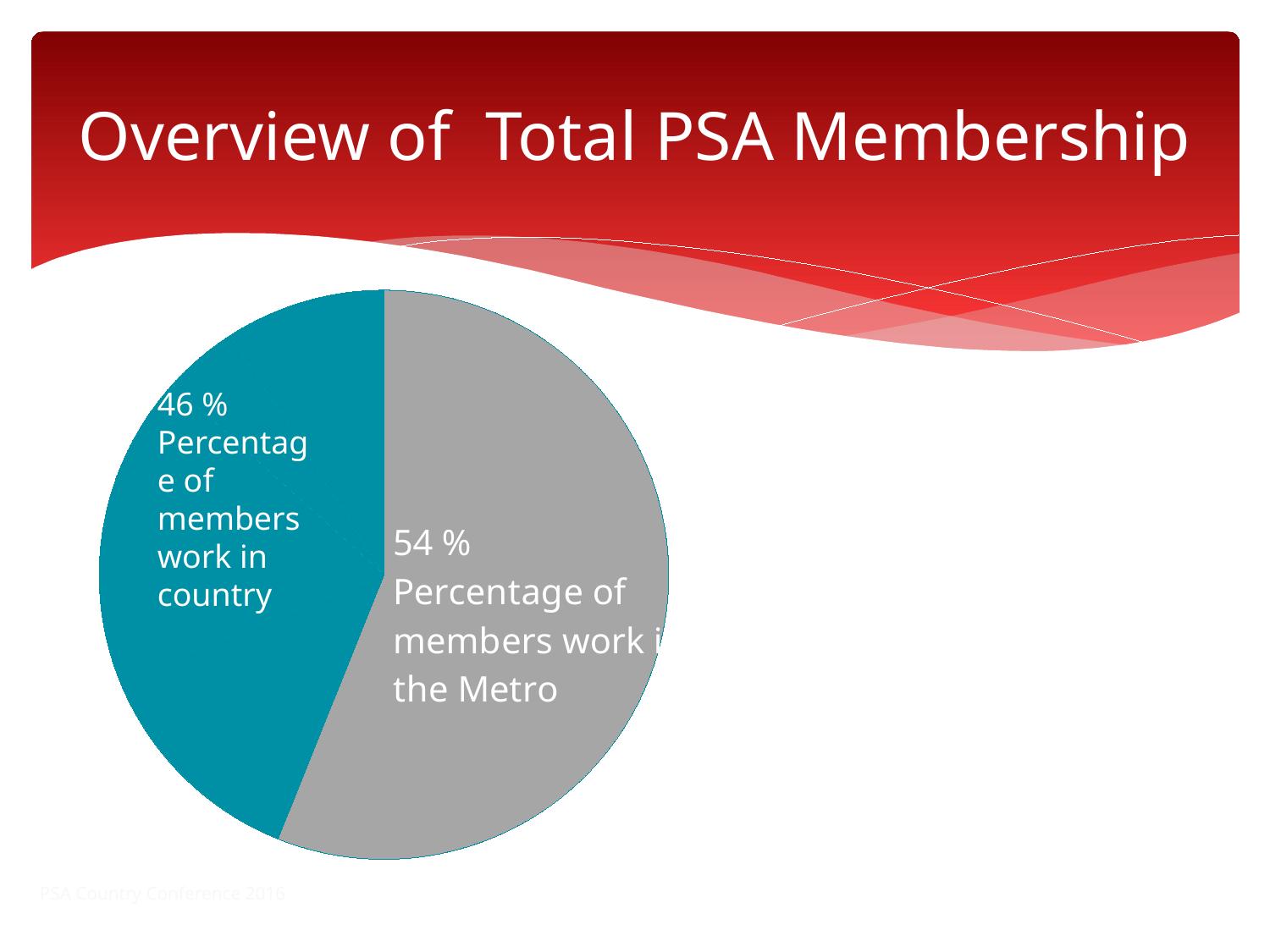
Which group has the smallest share of the pie? members work in country Is the share of members working in country greater or less than 50%? less What is the difference in percentage points between the Metro share and the country share? 8 What kind of chart is shown on the slide? pie chart What percentage of members work in the Metro? 54 % Which slice of the pie is larger: members working in country or members working in the Metro? members work in the Metro What colour is the slice for members working in country? teal Which group has the largest share of the pie? members work in the Metro How many slices does the pie chart have? 2 What percentage of members work in country? 46 % What colour is the slice for members working in the Metro? grey